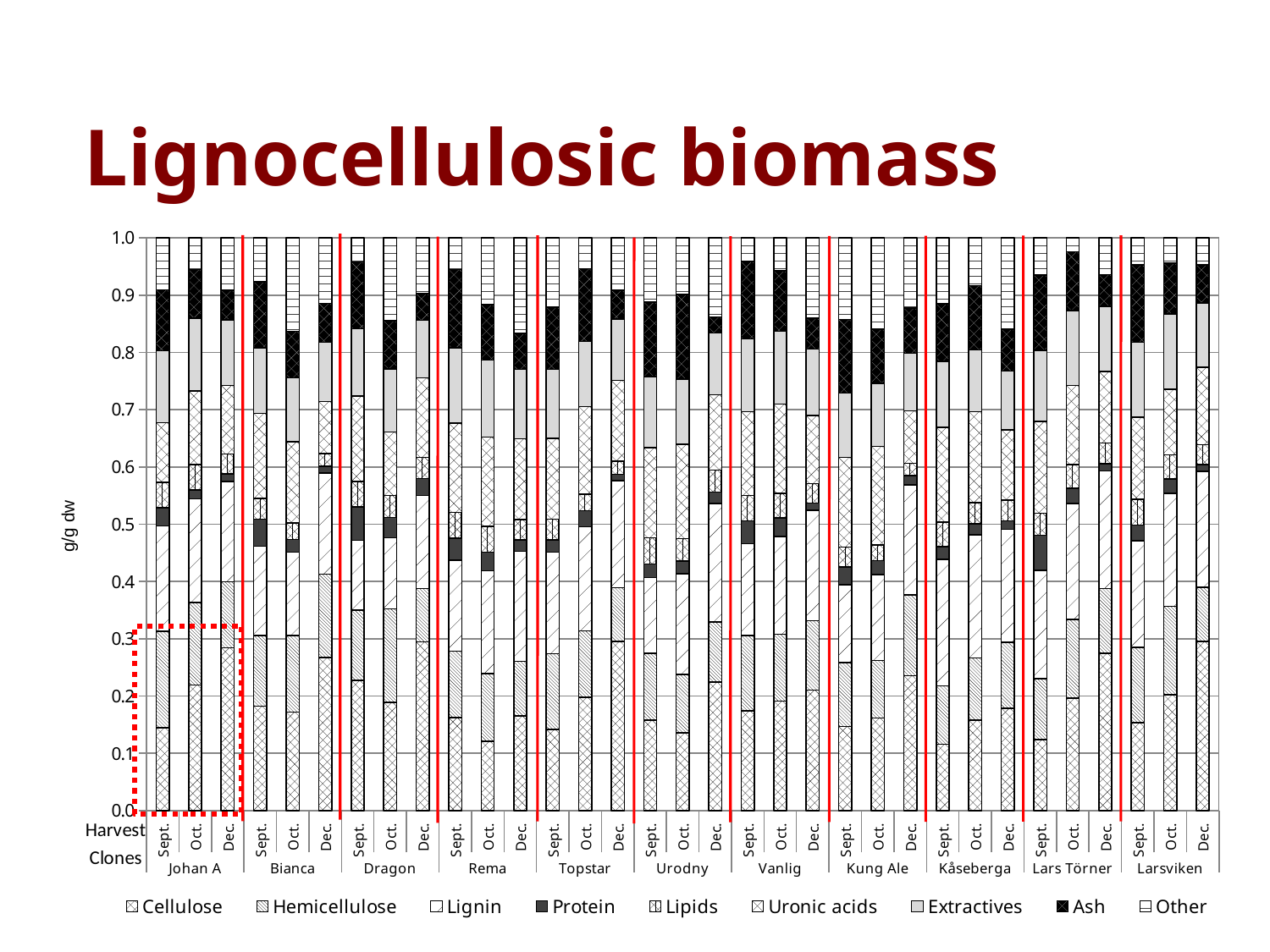
How many clones are shown along the x axis? 11 Which has the larger Cellulose value, Johan A Sept. or Johan A Dec.? Johan A Dec. How many series does the legend list? 9 What is the label on the y axis? g/g dw What is the total height of the stacked bar for Johan A Sept.? 1.0 What kind of chart is shown on the slide? bar chart Is the Cellulose value for Urodny Oct. greater or less than 0.2? less How many harvest dates are shown for each clone? 3 Which series is listed first in the legend? Cellulose Is the Cellulose value for Johan A Sept. greater or less than 0.2? less How many stacked bars are plotted in total? 33